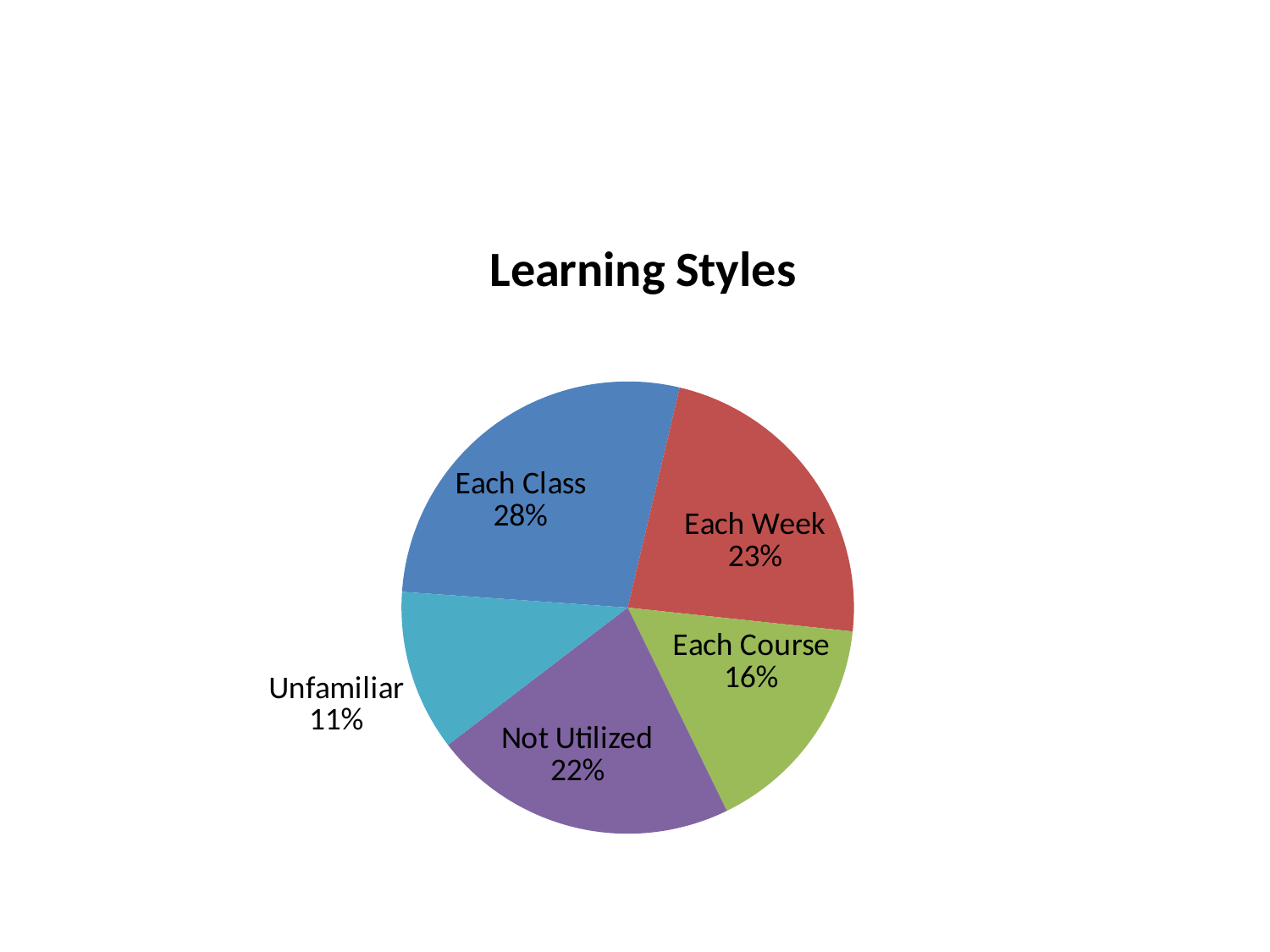
What share of the pie is labelled Not Utilized? 22% What is the difference in percentage points between Each Class and Unfamiliar? 17 Which category has the largest slice of the pie? Each Class How many categories are shown in the pie chart? 5 What share of the pie is labelled Each Week? 23% What share of the pie is labelled Each Course? 16% What is the title of the chart? Learning Styles Which category has the smallest slice of the pie? Unfamiliar What type of chart is shown on the slide? pie chart Which is larger, the share for Each Week or the share for Each Course? Each Week